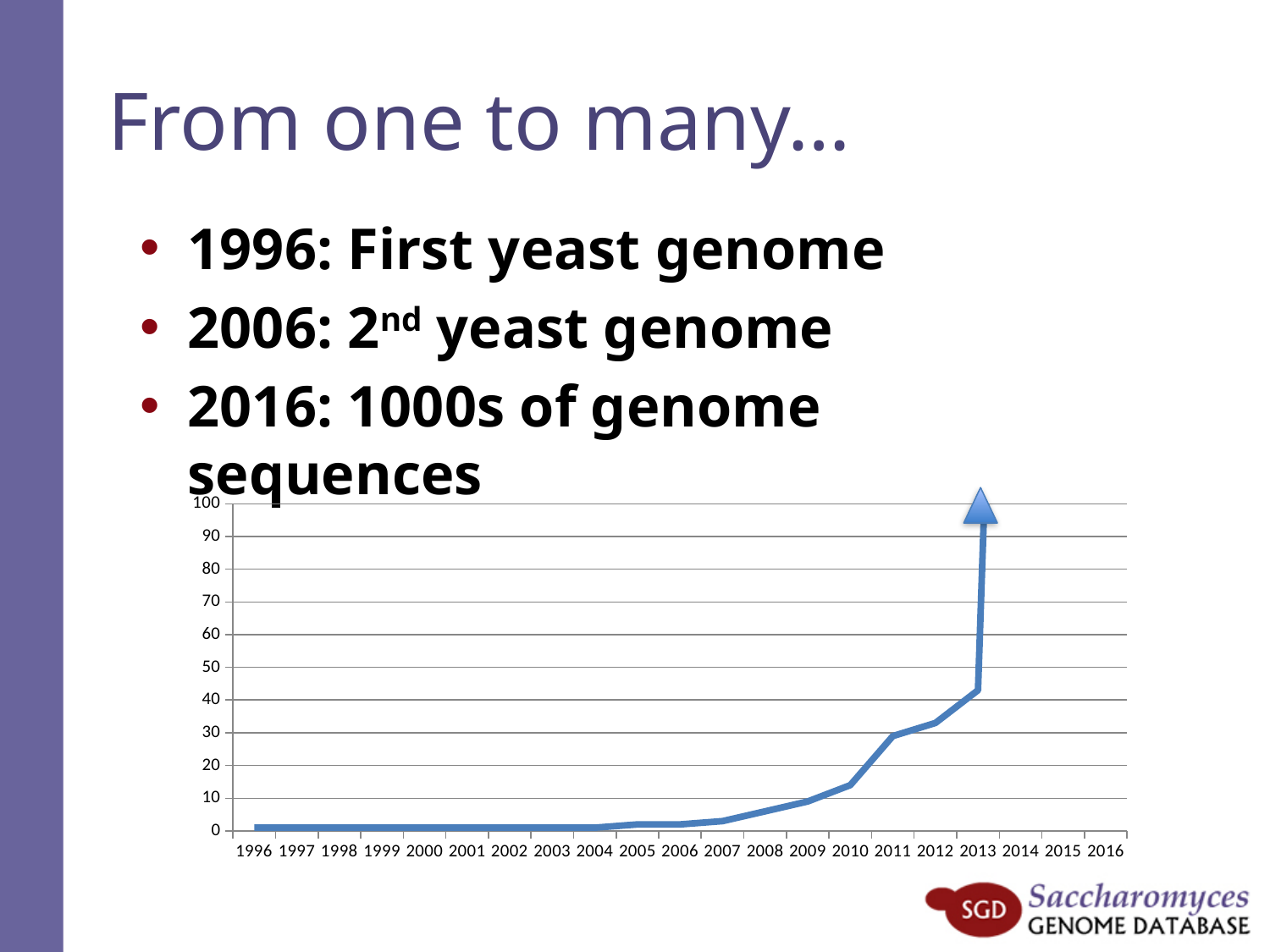
Is the value for 2010 greater or less than 10? greater Which year has the larger plotted value, 2013 or 2011? 2013 What kind of chart is shown on the slide? line chart Is the value for 2011 greater or less than 40? less What is the maximum value shown on the y axis of the chart? 100 Do the plotted values rise or fall from 1996 to 2013? rise Is the value for 2012 greater or less than 50? less How many years are labelled along the x axis of the chart? 21 Which year has the larger plotted value, 2010 or 2005? 2010